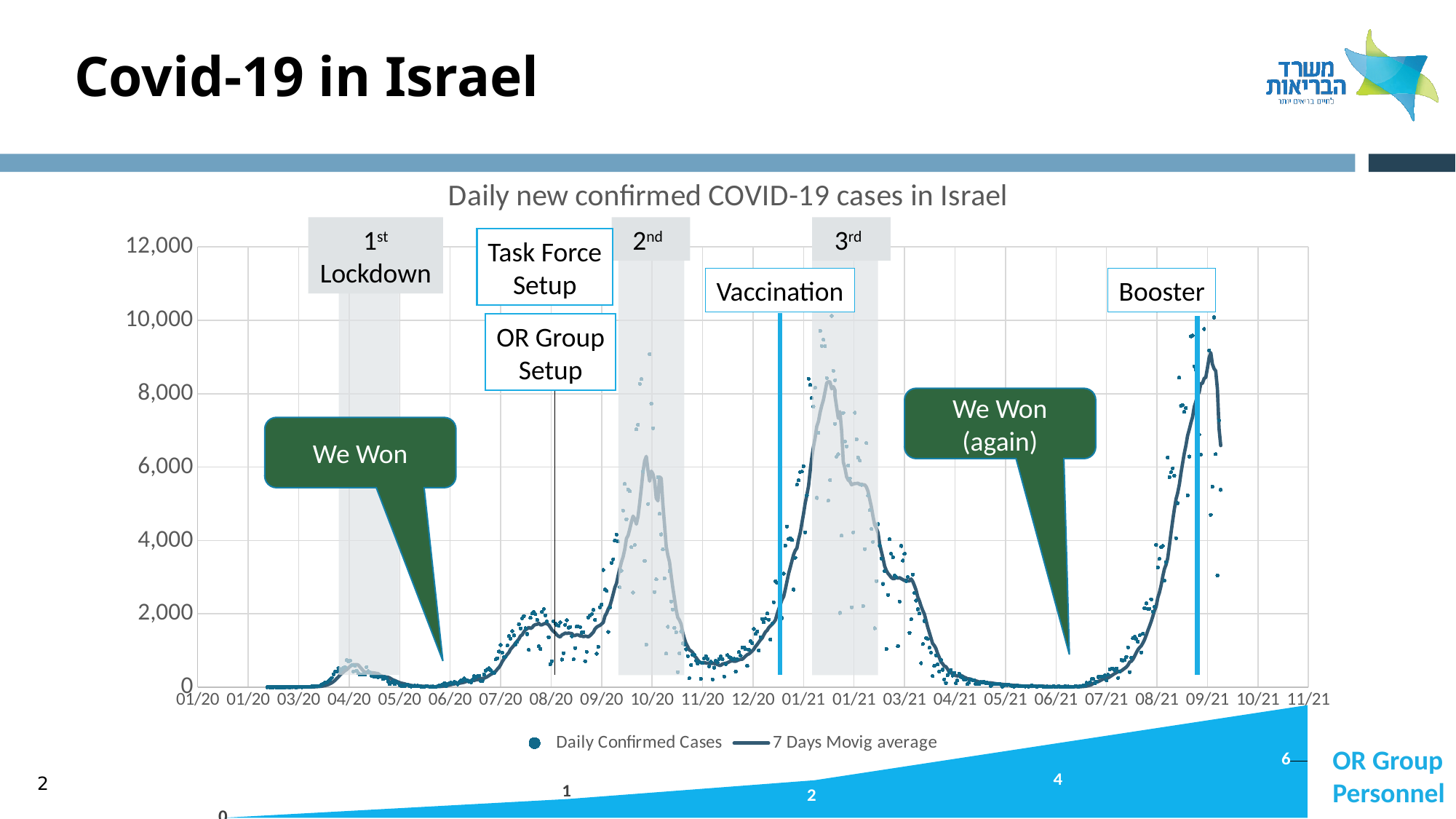
Is the peak of the 7-day moving average during the 2nd lockdown (around 10/20) greater or less than 4,000? greater What are the two series named in the legend? Daily Confirmed Cases and 7 Days Movig average Which wave had the higher peak in the 7-day moving average: the 2nd lockdown wave (around 10/20) or the 3rd lockdown wave (around 01/21)? 3rd lockdown wave Is the peak of the 7-day moving average around 09/21 greater or less than 8,000? greater What kind of chart is used to show the daily confirmed cases and the 7-day moving average? Line chart with scatter points Between 06/21 and 09/21, does the 7-day moving average rise or fall? rise How many series does the chart legend list? 2 Between 01/21 and 06/21, does the 7-day moving average rise or fall overall? fall What is the title of the chart? Daily new confirmed COVID-19 cases in Israel What is the highest value shown on the vertical axis? 12,000 Is the peak of the 7-day moving average during the 1st lockdown (around 04/20) greater or less than 2,000? less